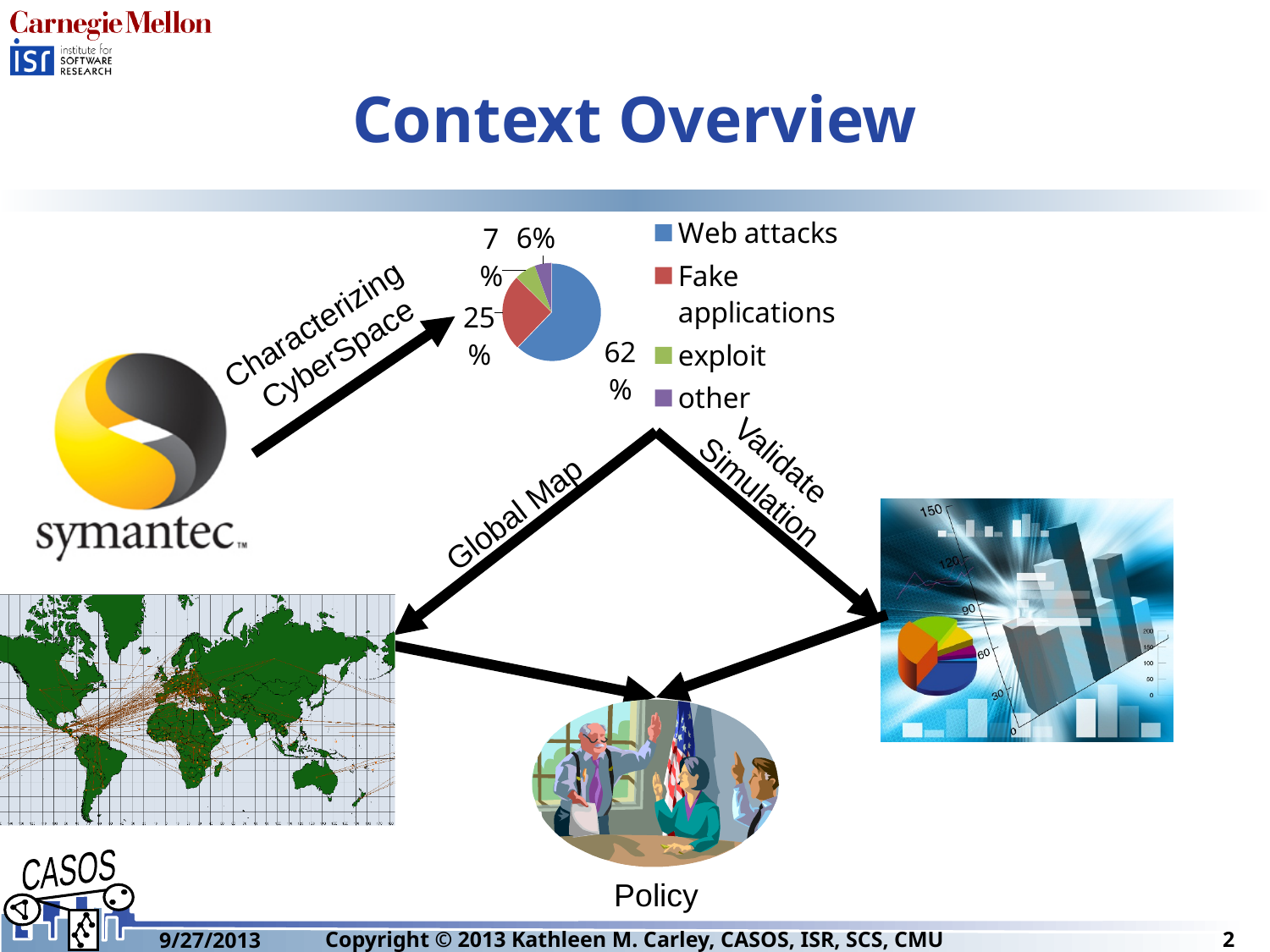
In the pie chart, what percentage is shown for Web attacks? 62% In the pie chart, what is the difference in percentage points between Web attacks and Fake applications? 37 How many categories does the pie chart's legend list? 4 In the pie chart, what colour is the exploit slice? green Which category has the largest slice in the pie chart? Web attacks In the pie chart, what percentage is shown for Fake applications? 25% In the pie chart, what percentage is shown for other? 6% In the pie chart, what percentage is shown for exploit? 7% Which category has the smallest slice in the pie chart? other In the pie chart, what colour is the Web attacks slice? blue What kind of chart is shown near the top of the slide next to the 'Characterizing CyberSpace' arrow? pie chart In the pie chart, which is larger: Fake applications or exploit? Fake applications